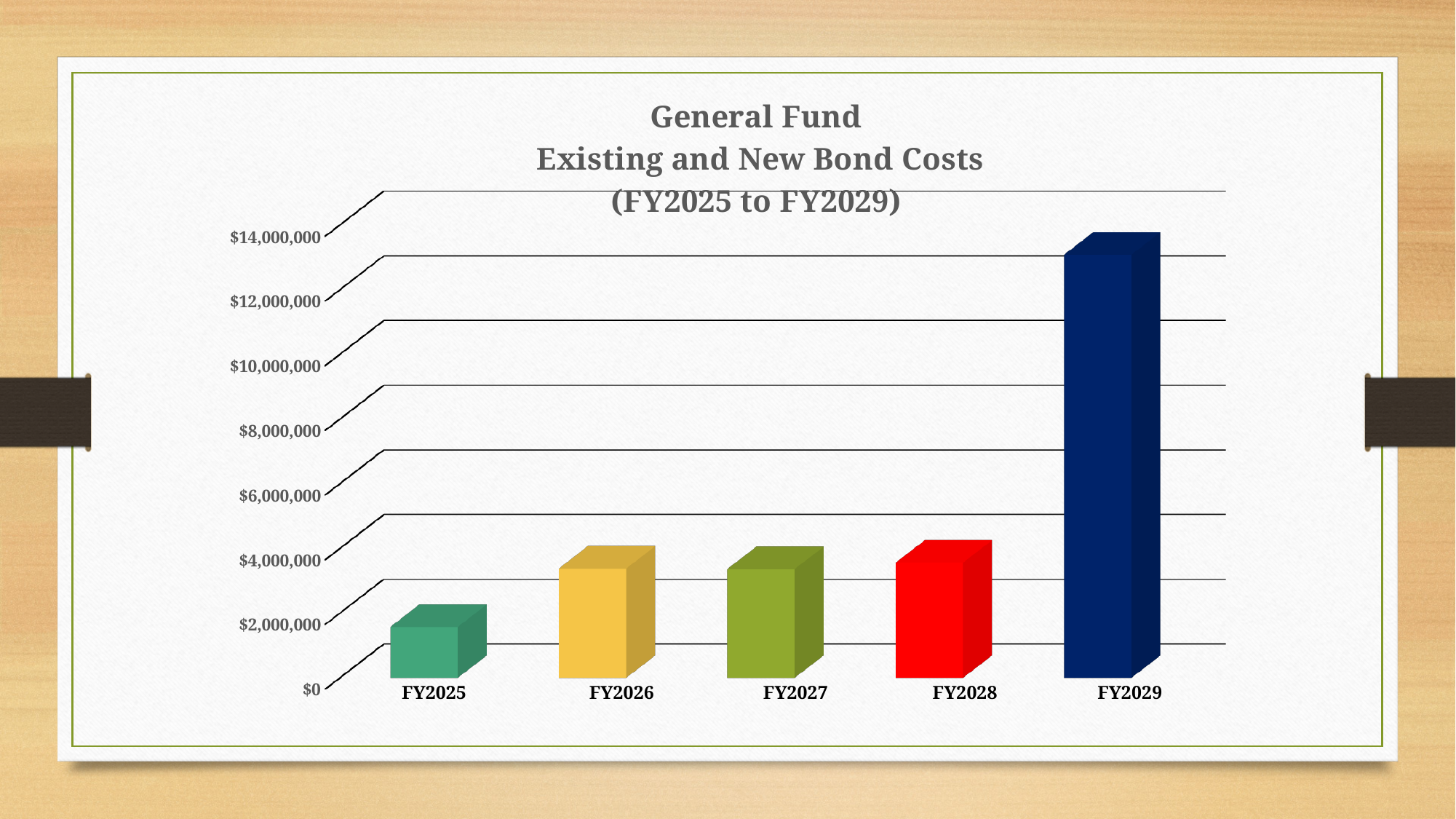
What is the title of the chart? General Fund Existing and New Bond Costs (FY2025 to FY2029) Which is larger, the value for FY2025 or the value for FY2027? FY2027 Does the value rise or fall from FY2028 to FY2029? rises Which fiscal year has the lowest bond cost? FY2025 What colour is the bar for FY2029? Dark blue Which is larger, the value for FY2029 or the value for FY2026? FY2029 Is the value for FY2026 greater or less than $2,000,000? greater Is the value for FY2029 greater or less than $10,000,000? greater What kind of chart is shown on the slide? Bar chart Is the value for FY2028 greater or less than $6,000,000? less Which fiscal year has the highest bond cost? FY2029 How many fiscal years are plotted in the chart? 5